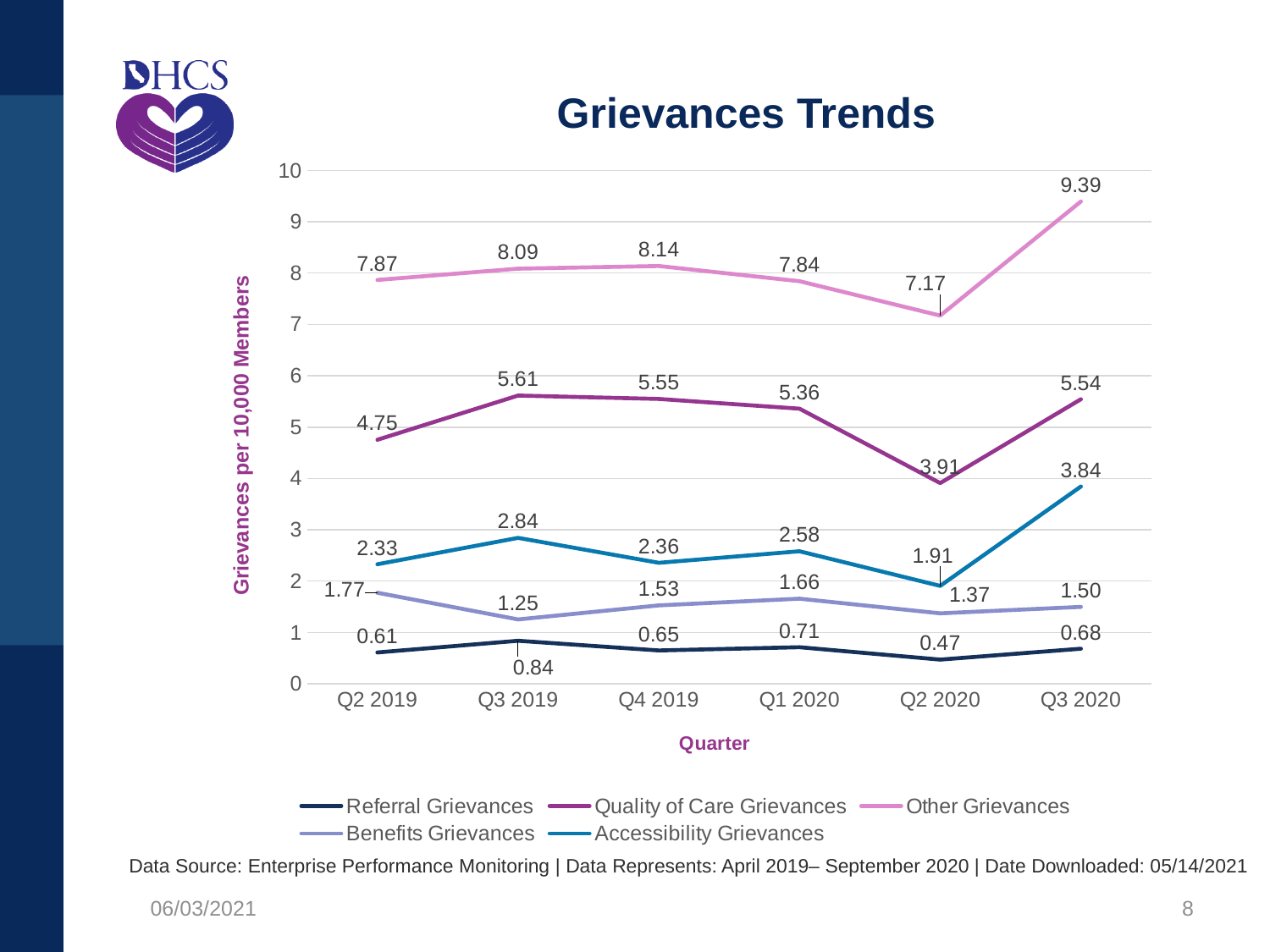
In which quarter is the value for Other Grievances lowest? Q2 2020 Which is larger in Q1 2020: Accessibility Grievances or Benefits Grievances? Accessibility Grievances What is the value for Accessibility Grievances in Q3 2019? 2.84 What is the value for Other Grievances in Q3 2020? 9.39 How many series does the legend list? 5 How many quarters are plotted on the x axis? 6 What is the value for Quality of Care Grievances in Q2 2020? 3.91 What type of chart is shown on the slide? Line chart What is the value for Referral Grievances in Q2 2020? 0.47 What is the label of the y axis? Grievances per 10,000 Members What is the difference between the Other Grievances values in Q3 2020 and Q2 2020? 2.22 In which quarter is the value for Benefits Grievances highest? Q2 2019